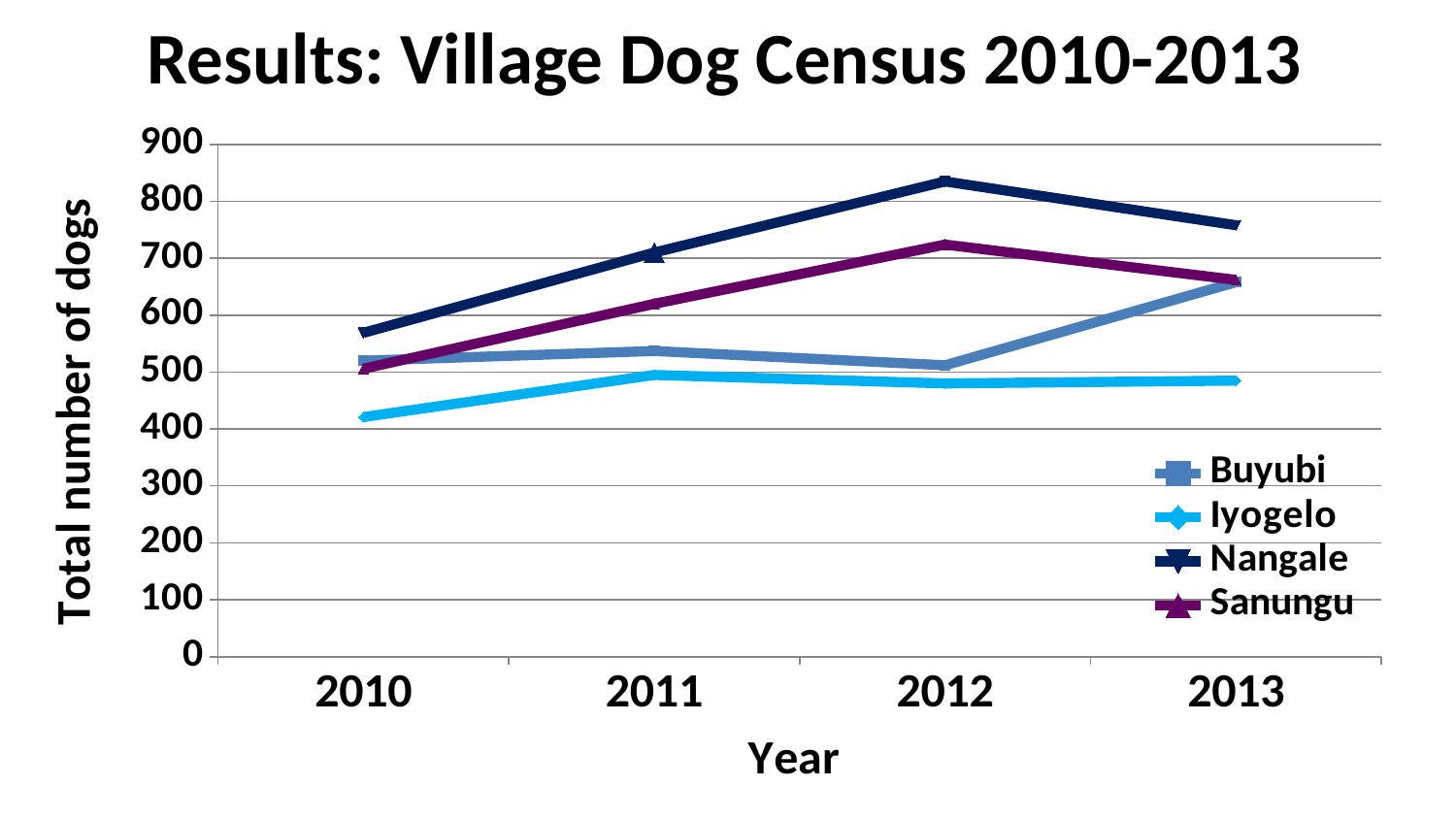
Is the value for Nangale in 2012 greater or less than 800? greater What is the label of the y axis? Total number of dogs Does the Nangale line rise or fall from 2012 to 2013? fall Is the value for Buyubi in 2013 greater or less than 600? greater Which village had the highest total number of dogs in 2012? Nangale How many series does the legend list? 4 How many years are plotted along the x axis? 4 Does the Nangale line rise or fall from 2010 to 2012? rise Which is larger in 2011, the value for Sanungu or the value for Buyubi? Sanungu Which village had the lowest total number of dogs in 2010? Iyogelo Is the value for Iyogelo in 2010 greater or less than 500? less What kind of chart is shown on the slide? line chart